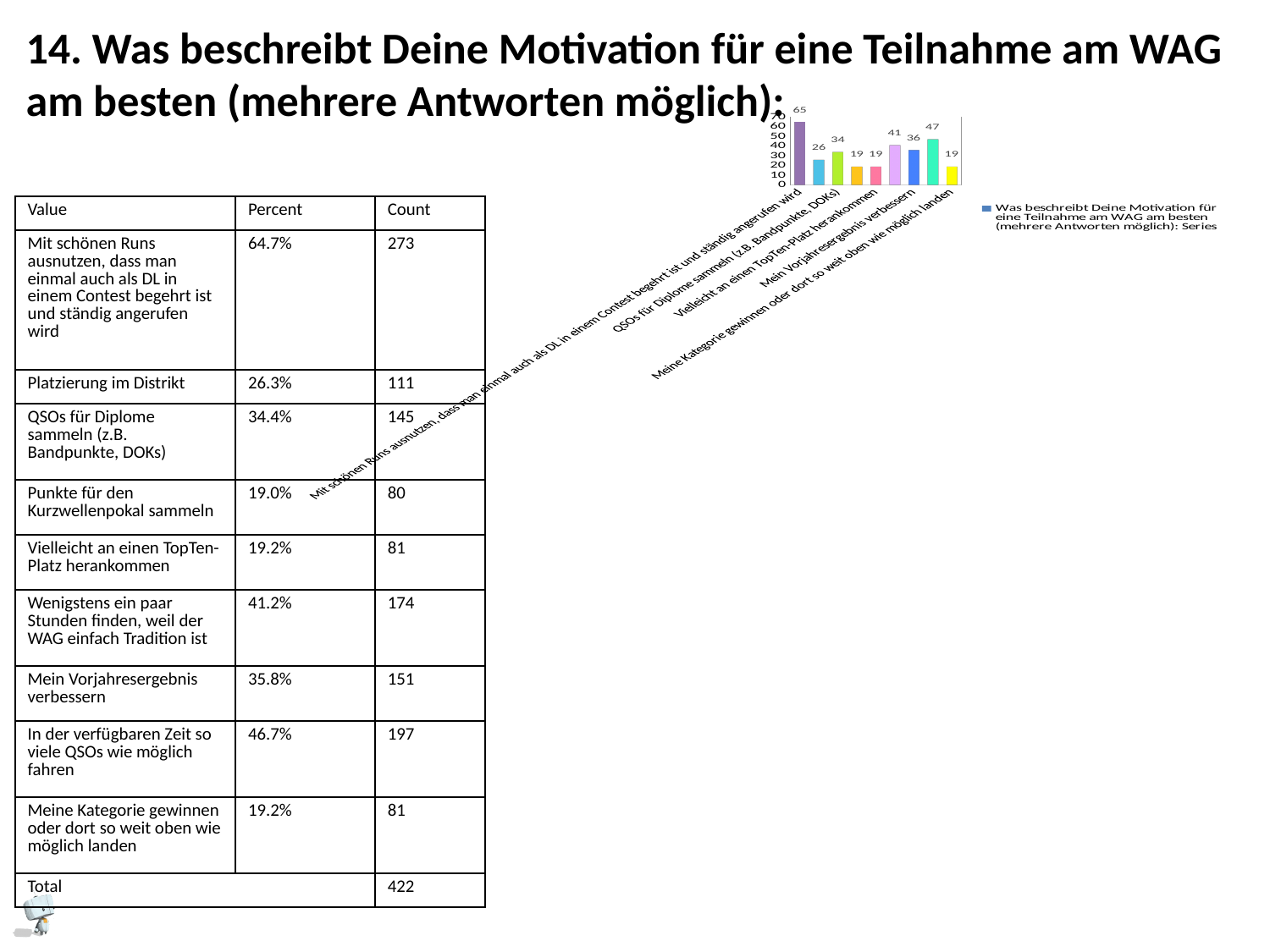
What is the difference between the bar for 'Mit schönen Runs ausnutzen...' and the bar for 'QSOs für Diplome sammeln (z.B. Bandpunkte, DOKs)'? 31 Is the value for 'Mit schönen Runs ausnutzen...' greater or less than 60? greater How many bars are plotted in the chart? 9 What is the highest value shown on the chart's vertical axis? 70 What is the value of the bar for 'QSOs für Diplome sammeln (z.B. Bandpunkte, DOKs)'? 34 What is the value of the bar for 'Mit schönen Runs ausnutzen, dass man einmal auch als DL in einem Contest begehrt ist und ständig angerufen wird'? 65 What type of chart is shown on the slide? bar chart What is the value of the bar for 'Mein Vorjahresergebnis verbessern'? 36 Which is larger: the bar for 'Mein Vorjahresergebnis verbessern' or the bar for 'Vielleicht an einen TopTen-Platz herankommen'? Mein Vorjahresergebnis verbessern Which category has the highest bar in the chart? Mit schönen Runs ausnutzen, dass man einmal auch als DL in einem Contest begehrt ist und ständig angerufen wird How many series does the chart legend list? 1 What is the value of the bar for 'Meine Kategorie gewinnen oder dort so weit oben wie möglich landen'? 19